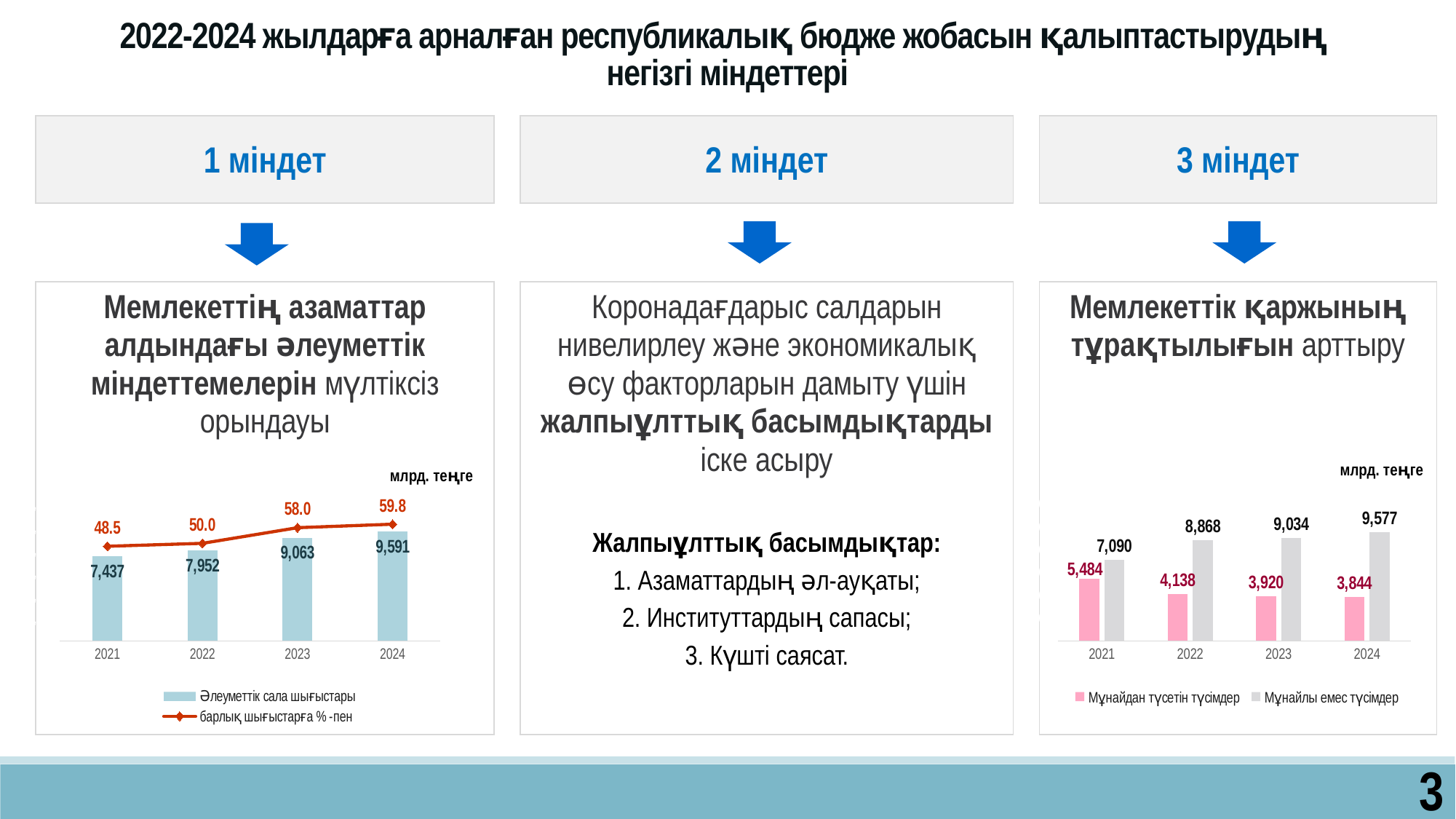
In the left chart (under "1 міндет"), which year has the highest Әлеуметтік сала шығыстары value? 2024 In the right chart (under "3 міндет"), what is the value of Мұнайдан түсетін түсімдер for 2024? 3,844 In the left chart (under "1 міндет"), what is the value of Әлеуметтік сала шығыстары for 2023? 9,063 In the right chart (under "3 міндет"), what is the value of Мұнайлы емес түсімдер for 2022? 8,868 In the right chart (under "3 міндет"), what is the difference between Мұнайлы емес түсімдер and Мұнайдан түсетін түсімдер in 2023? 5,114 In the right chart (under "3 міндет"), which year has the lowest Мұнайдан түсетін түсімдер value? 2024 In the left chart (under "1 міндет"), do the Әлеуметтік сала шығыстары values rise or fall from 2021 to 2024? rise In the right chart (under "3 міндет"), how many years are shown on the x axis? 4 In the left chart (under "1 міндет"), what is the difference between the Әлеуметтік сала шығыстары values for 2024 and 2021? 2,154 In the left chart (under "1 міндет"), what is the value of the line барлық шығыстарға % -пен for 2022? 50.0 In the left chart (under "1 міндет"), how many series does the legend list? 2 In the right chart (under "3 міндет"), which is larger for 2021: Мұнайдан түсетін түсімдер or Мұнайлы емес түсімдер? Мұнайлы емес түсімдер